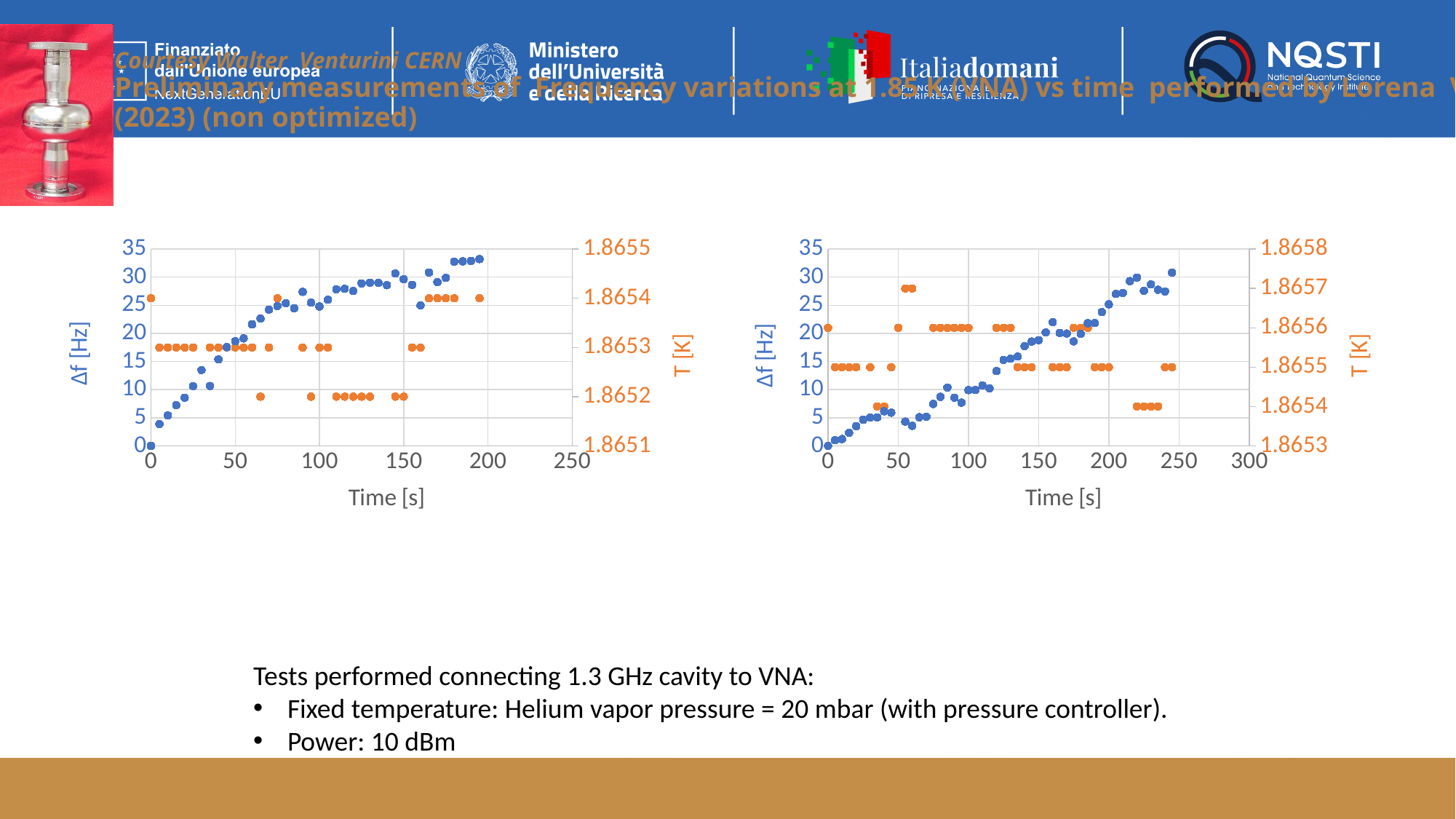
In the left chart, what is the label of the x axis? Time [s] In the left chart, is the Δf value at about 20 s greater or less than 10? less In the left chart, do the Δf [Hz] values rise or fall as time increases? rise In the right chart, do the Δf [Hz] values rise or fall as time increases? rise How many charts are shown on the slide? 2 In the right chart, is the Δf value at about 50 s greater or less than 10? less What kind of chart is the left chart on the slide? scatter chart In the right chart, what is the label of the right-hand y axis? T [K] In the right chart, is the Δf value at about 245 s greater or less than 25? greater